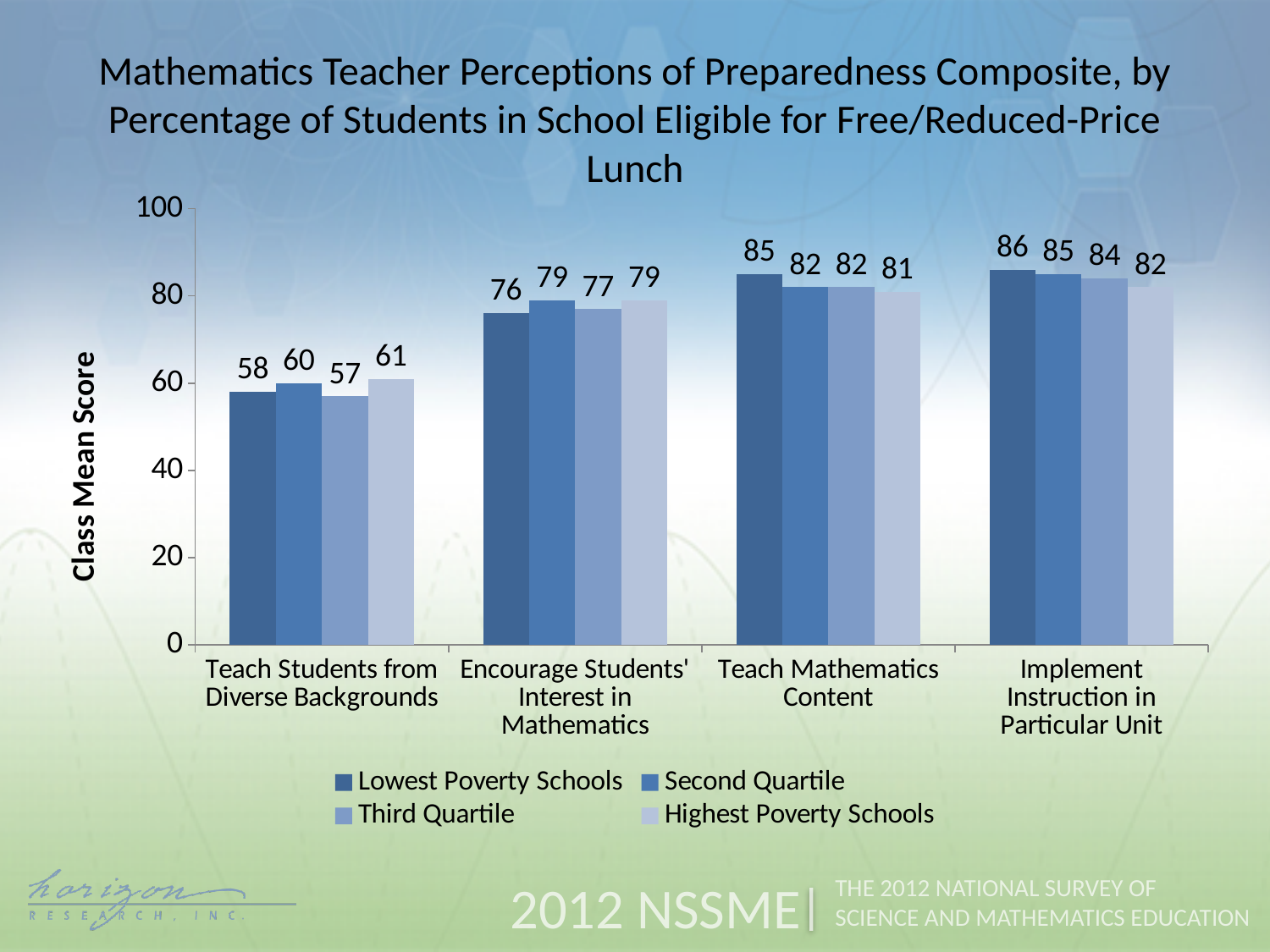
What is the value for Highest Poverty Schools in the Encourage Students' Interest in Mathematics category? 79 How many categories are shown on the x axis? 4 What kind of chart is shown on the slide? bar chart Which series has the lowest value in the Teach Students from Diverse Backgrounds category? Third Quartile What is the value for Third Quartile in the Implement Instruction in Particular Unit category? 84 Which is larger: the Second Quartile value for Teach Mathematics Content or the Second Quartile value for Encourage Students' Interest in Mathematics? Teach Mathematics Content Is the value for Highest Poverty Schools in the Teach Students from Diverse Backgrounds category greater or less than 80? less What is the difference between the Lowest Poverty Schools and Highest Poverty Schools values in the Implement Instruction in Particular Unit category? 4 Which series has the highest value in the Teach Mathematics Content category? Lowest Poverty Schools How many series does the legend list? 4 What is the label of the y axis? Class Mean Score What is the value for Lowest Poverty Schools in the Teach Students from Diverse Backgrounds category? 58